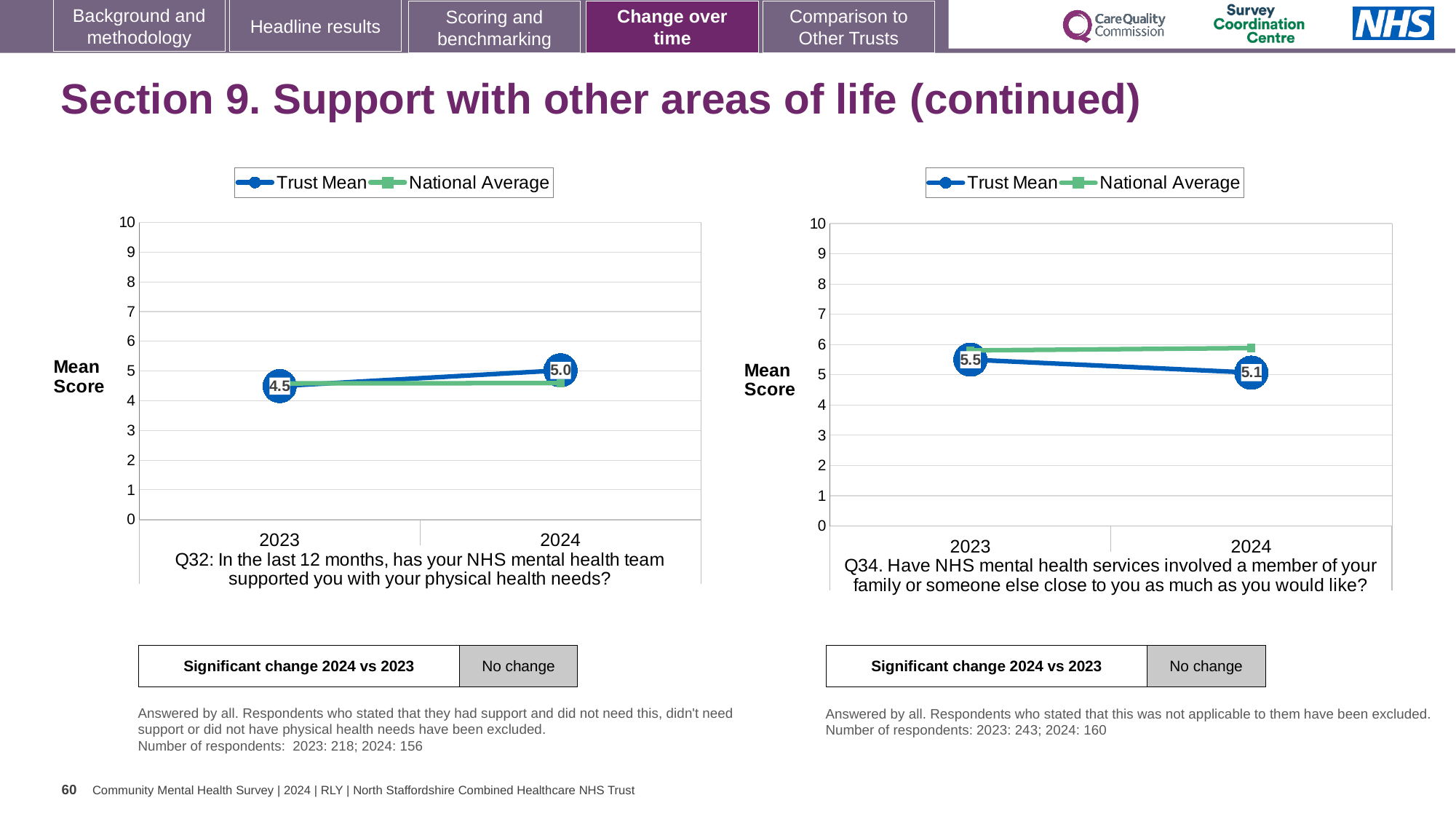
What type of chart is used on the left of the slide (Q32)? line chart On the left chart (Q32), what is the Trust Mean score for 2023? 4.5 On the left chart (Q32), by how much did the Trust Mean change from 2023 to 2024? 0.5 On the right chart (Q34), what is the Trust Mean score for 2023? 5.5 On the left chart (Q32), is the National Average value for 2024 greater or less than 5? less On the right chart (Q34), does the Trust Mean rise or fall from 2023 to 2024? fall On the right chart (Q34), in 2024 which is larger, the Trust Mean or the National Average? National Average On the left chart (Q32), what is the Trust Mean score for 2024? 5.0 On the right chart (Q34), what is the difference between the Trust Mean in 2023 and 2024? 0.4 On the right chart (Q34), what is the Trust Mean score for 2024? 5.1 On the left chart (Q32), does the Trust Mean rise or fall from 2023 to 2024? rise How many series does the legend of the right chart (Q34) list? 2